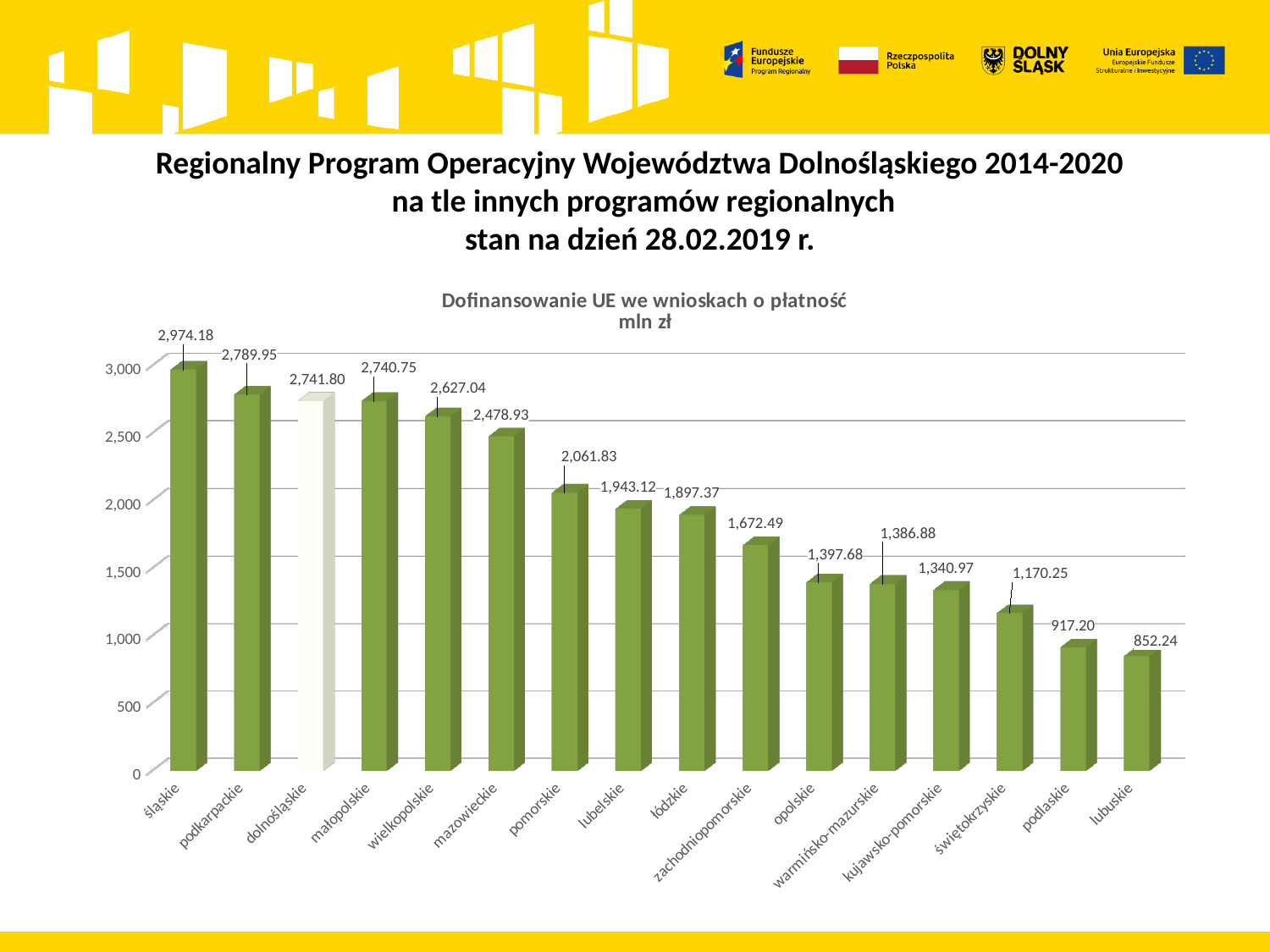
Which region has the lowest value in the chart? lubuskie What is the value for śląskie in the chart "Dofinansowanie UE we wnioskach o płatność"? 2,974.18 What is the difference between the values for śląskie and lubuskie? 2,121.94 What is the value for podlaskie? 917.20 What is the value for dolnośląskie? 2,741.80 Is the value for świętokrzyskie greater or less than 1,000? greater Do the values rise or fall from left to right along the x axis? fall Which region has the highest value in the chart? śląskie Which has a larger value, pomorskie or opolskie? pomorskie What kind of chart is shown on the slide? bar chart What is the value for zachodniopomorskie? 1,672.49 How many regions are shown in the chart? 16